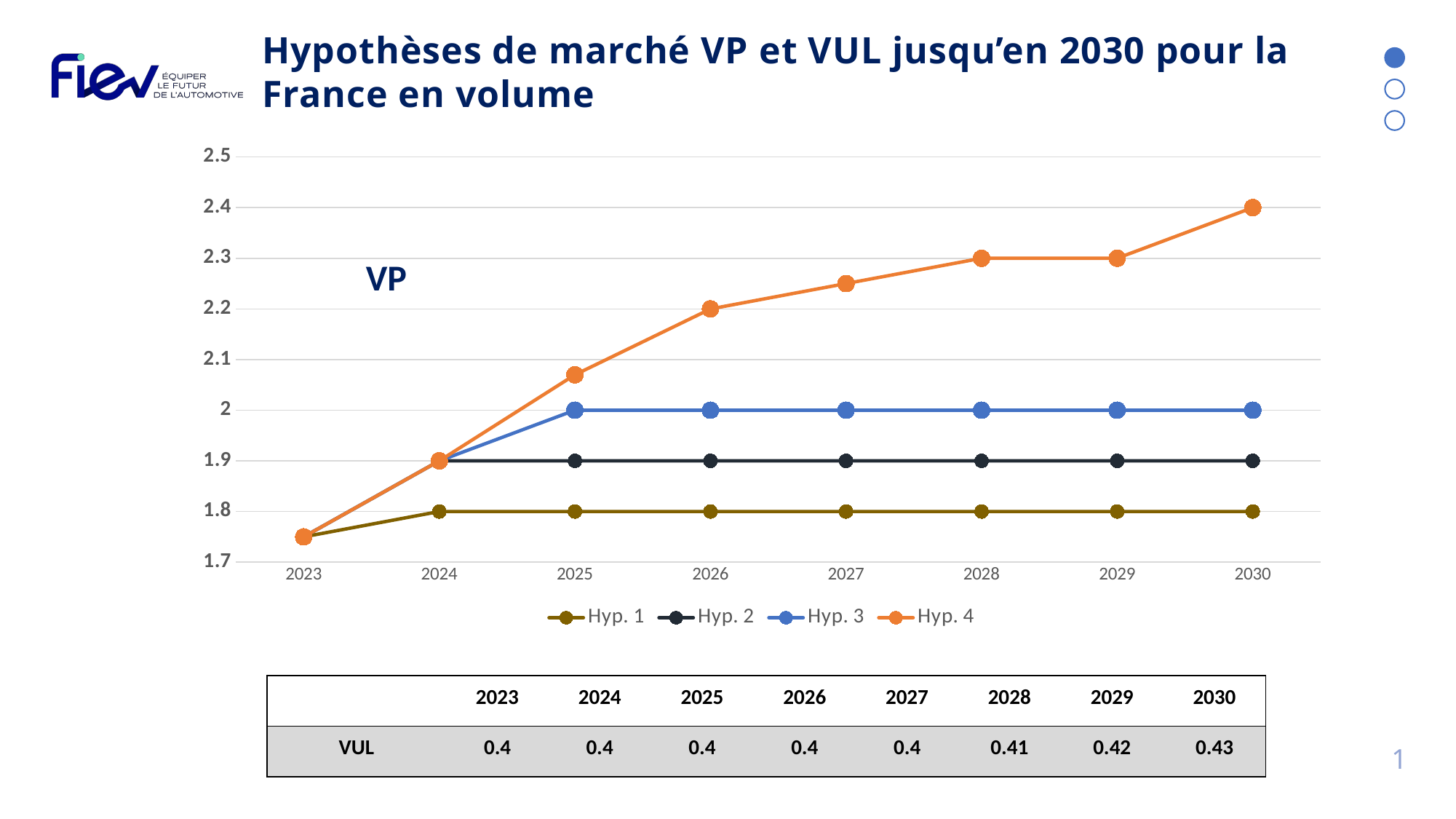
In the VP chart, is the value for Hyp. 4 in 2025 greater or less than 2? greater What kind of chart is shown on the slide? line chart In the VP chart, what is the difference between Hyp. 4 and Hyp. 2 in 2030? 0.5 In the VP chart, does the Hyp. 4 series rise or fall from 2023 to 2030? rises How many series does the legend of the VP chart list? 4 In the VP chart, what is the value of Hyp. 3 in 2028? 2 In the VP chart, which is larger in 2026: Hyp. 4 or Hyp. 3? Hyp. 4 In the VP chart, what is the value of Hyp. 1 in 2030? 1.8 In the VP chart, which series has the lowest value in 2030? Hyp. 1 How many years are plotted along the x axis of the VP chart? 8 In the VP chart, what is the value of Hyp. 4 in 2030? 2.4 In the VP chart, which series has the highest value in 2030? Hyp. 4